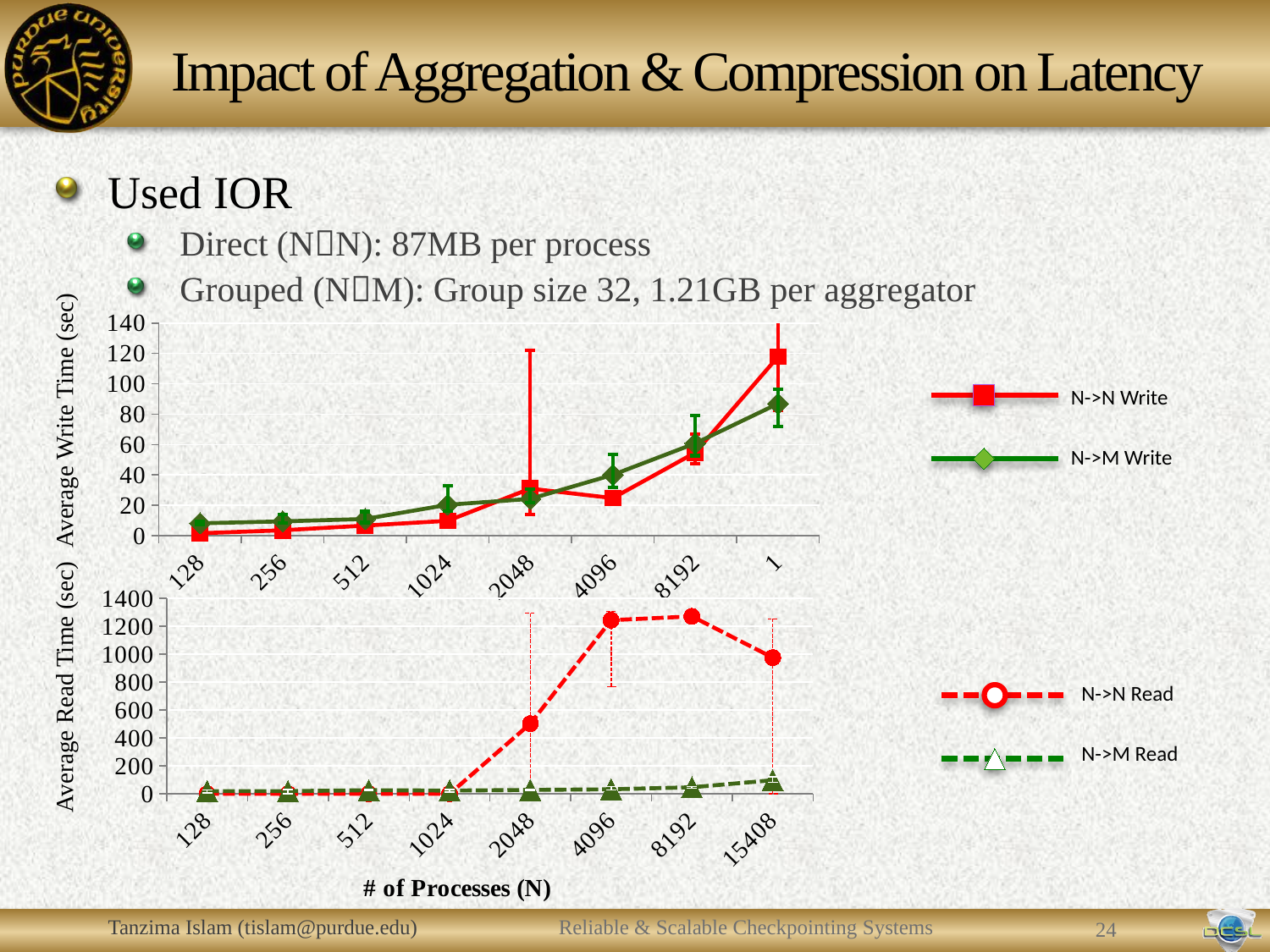
In the bottom chart (Average Read Time), which series has the larger value at 4096 processes, N->N Read or N->M Read? N->N Read How many process counts are plotted along the x axis of the bottom chart (Average Read Time)? 8 In the top chart (Average Write Time), does the N->M Write series generally rise or fall as the number of processes increases? rise What is the label of the shared x axis below the bottom chart? # of Processes (N) In the top chart (Average Write Time), which series has the larger value at 4096 processes, N->N Write or N->M Write? N->M Write In the top chart (Average Write Time), is the N->N Write value at 8192 processes greater or less than 80? less In the bottom chart (Average Read Time), is the N->N Read value at 2048 processes greater or less than 200? greater What kind of chart is the top chart (Average Write Time)? line chart How many series does the legend of the bottom chart (Average Read Time) list? 2 In the top chart (Average Write Time), is the N->M Write value at 4096 processes greater or less than 60? less